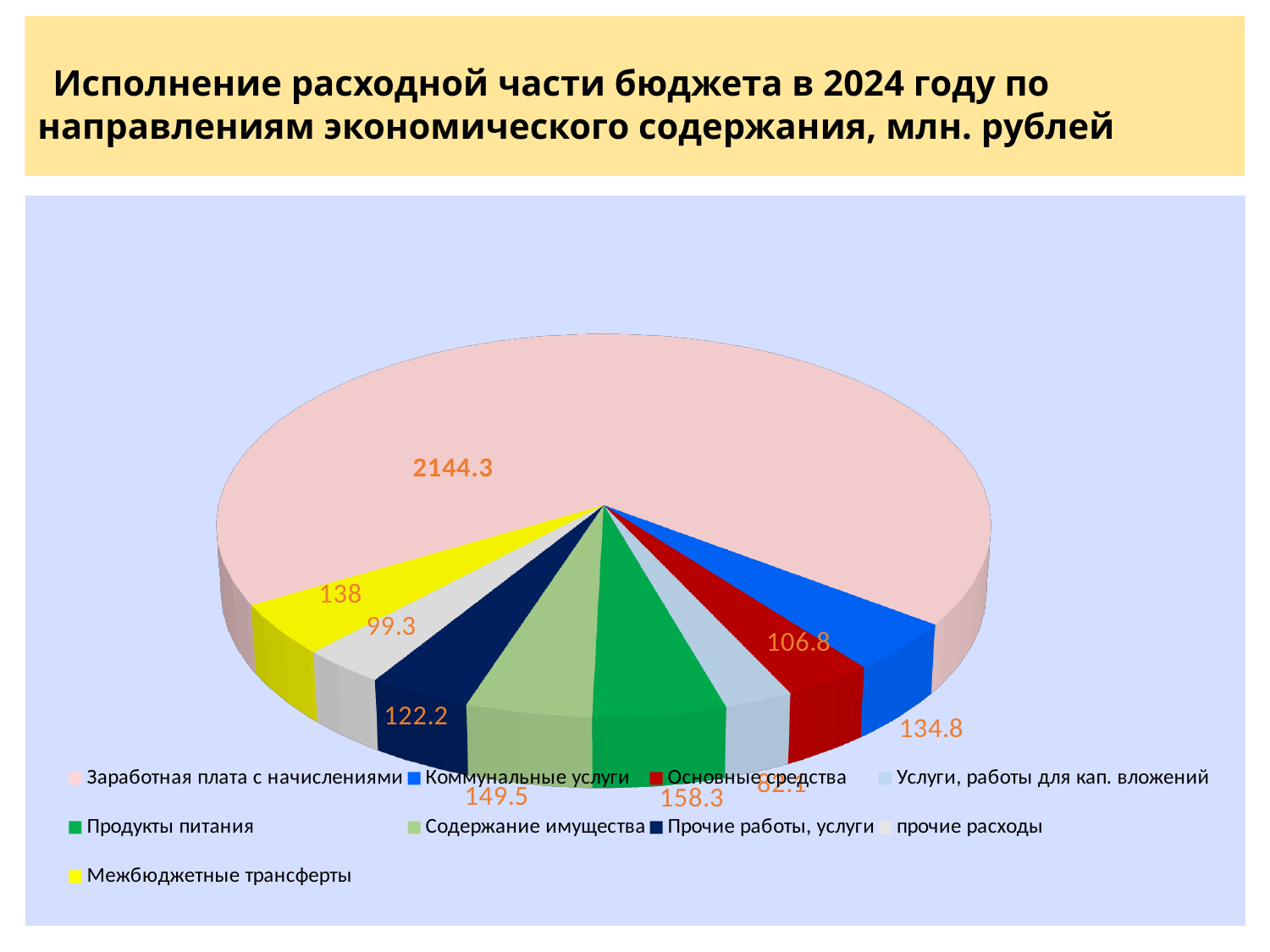
What is the difference between the values for Продукты питания and Содержание имущества? 8.8 What is the value for Коммунальные услуги? 134.8 Which category has the smallest slice of the pie? Услуги, работы для кап. вложений How many categories does the pie chart show? 9 Which is larger: the value for Коммунальные услуги or the value for Прочие работы, услуги? Коммунальные услуги What is the value for Основные средства? 106.8 What type of chart is shown on the slide? Pie chart What is the value for Межбюджетные трансферты? 138 What is the value for Заработная плата с начислениями? 2144.3 Which category has the largest slice of the pie? Заработная плата с начислениями What is the value for Продукты питания? 158.3 What is the value for Прочие работы, услуги? 122.2